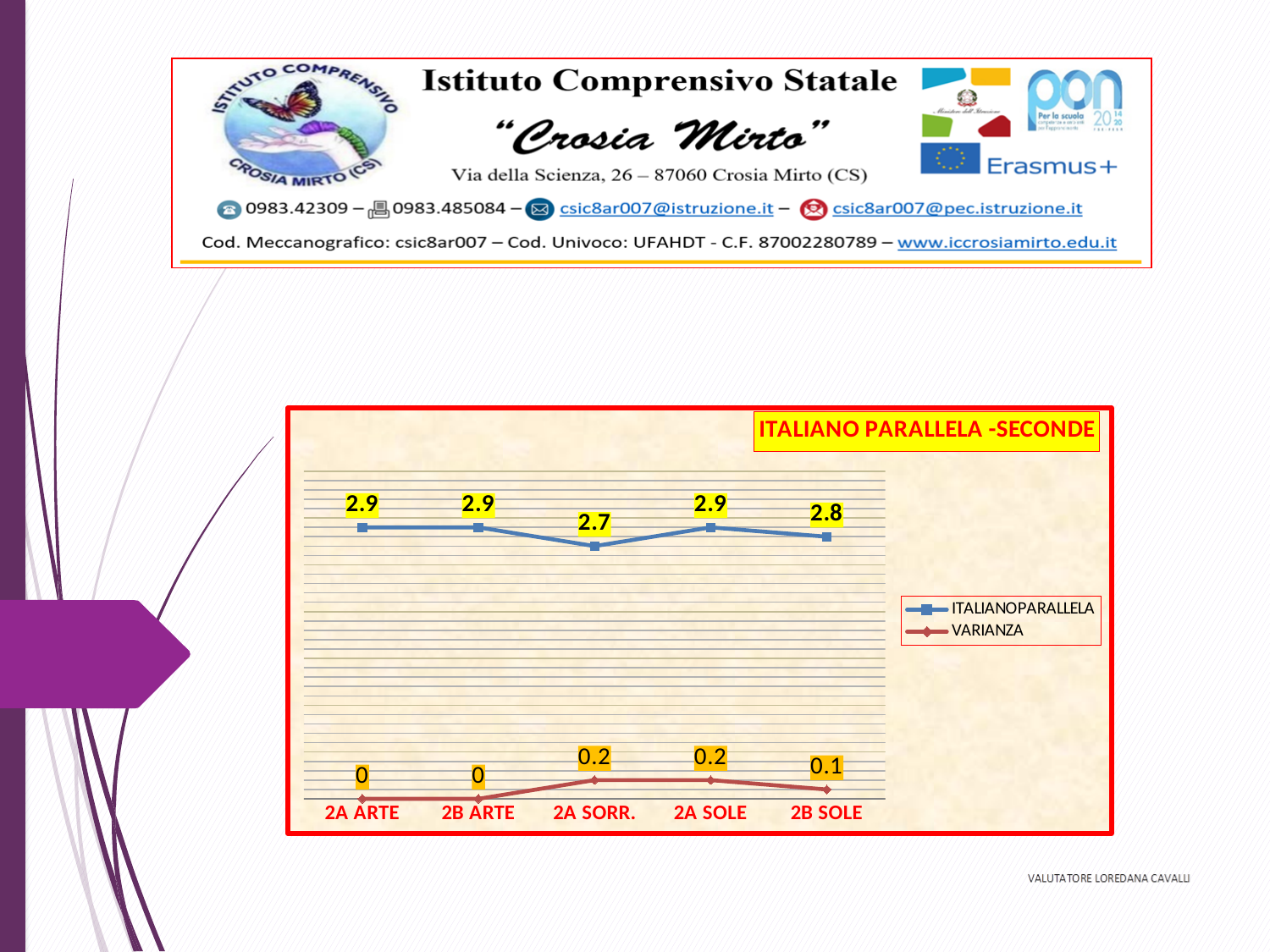
What is the ITALIANOPARALLELA value for 2A SORR.? 2.7 What is the title of the chart? ITALIANO PARALLELA -SECONDE What is the ITALIANOPARALLELA value for 2B SOLE? 2.8 How many series does the legend list? 2 Which category has the lowest ITALIANOPARALLELA value? 2A SORR. Which series is drawn in red? VARIANZA What is the VARIANZA value for 2A ARTE? 0 Which is larger, the VARIANZA value for 2A SOLE or for 2B SOLE? 2A SOLE What is the VARIANZA value for 2B SOLE? 0.1 What is the difference between the ITALIANOPARALLELA values for 2A ARTE and 2A SORR.? 0.2 What kind of chart is shown? Line chart How many categories are shown on the x axis? 5